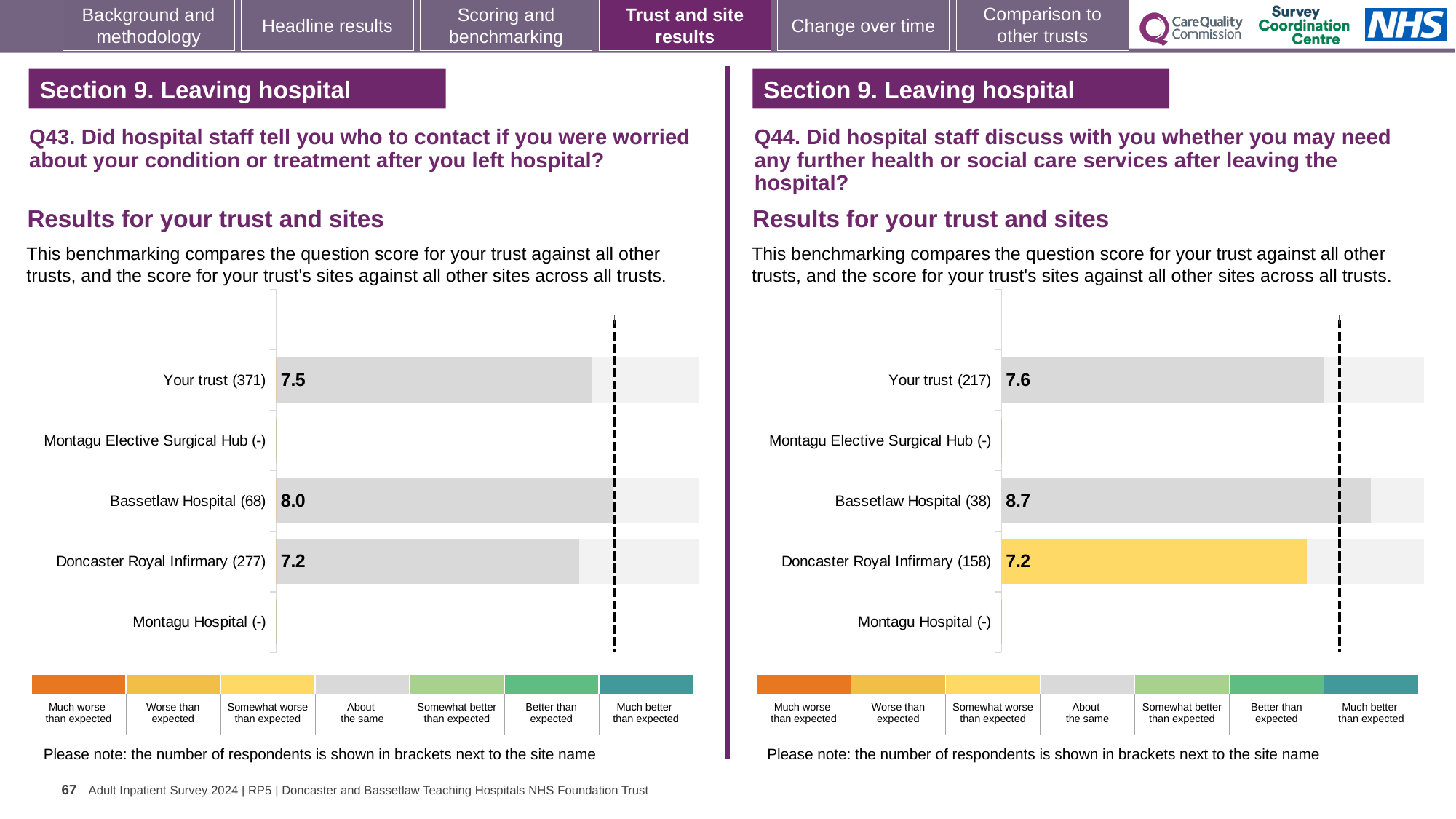
In the Q44 chart on the right, what is the difference between the scores for Bassetlaw Hospital and Your trust? 1.1 In the Q43 chart on the left, what is the score for Your trust? 7.5 In the Q43 chart on the left, what is the score for Bassetlaw Hospital? 8.0 In the Q43 chart on the left, what is the difference between the scores for Bassetlaw Hospital and Doncaster Royal Infirmary? 0.8 In the Q44 chart on the right, which site or trust has the highest score? Bassetlaw Hospital How many categories (trust and sites) are listed on the y axis of the Q44 chart on the right? 5 In the Q44 chart on the right, what is the score for Doncaster Royal Infirmary? 7.2 In the Q44 chart on the right, what is the score for Bassetlaw Hospital? 8.7 What kind of chart is used for the Q43 results on the left? Bar chart In the Q44 chart on the right, which benchmark category does the colour of the Doncaster Royal Infirmary bar indicate? Somewhat worse than expected In the Q43 chart on the left, which has the larger score, Your trust or Doncaster Royal Infirmary? Your trust In the Q43 chart on the left, which site or trust has the lowest score? Doncaster Royal Infirmary